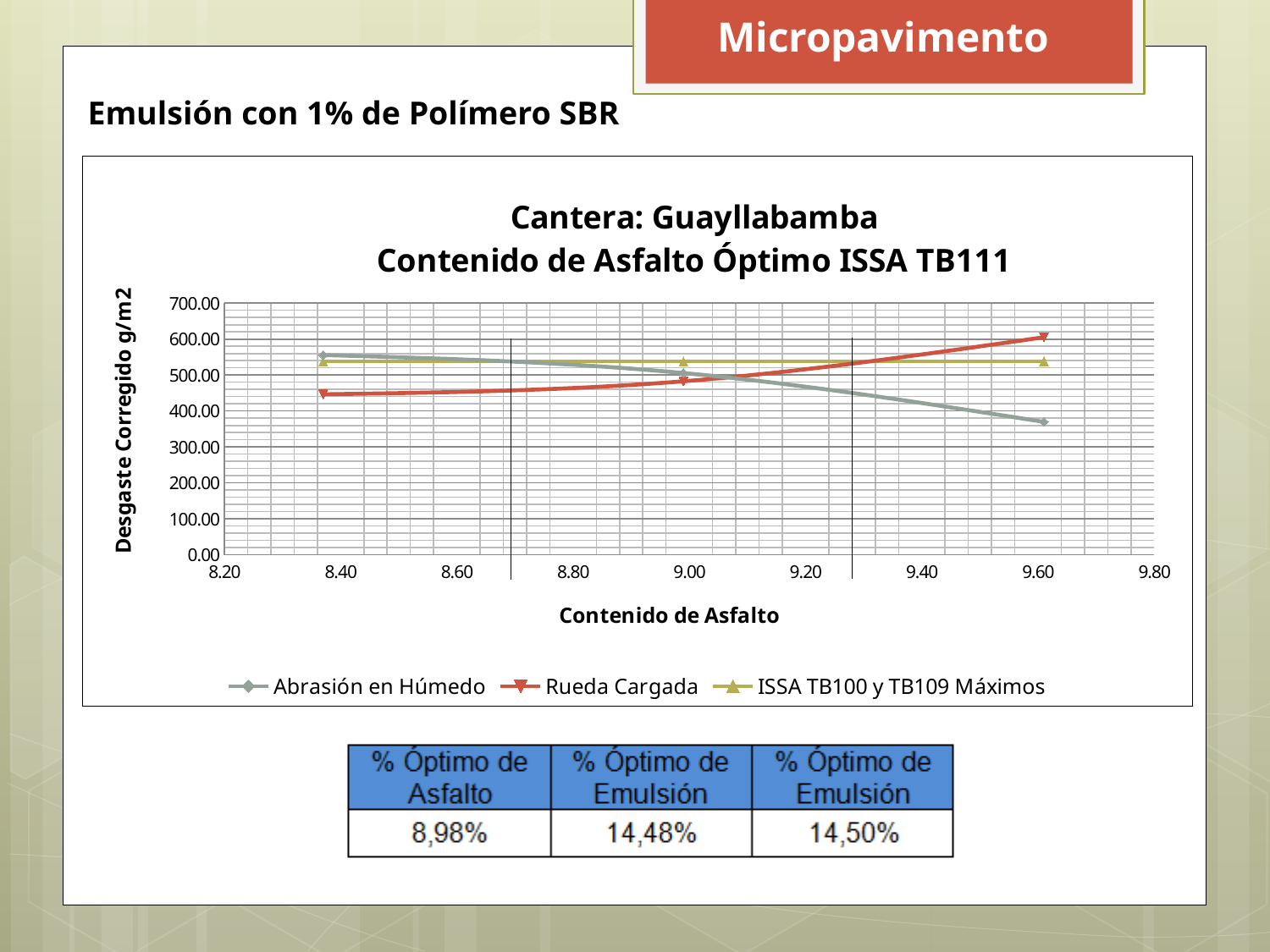
Is the value of Abrasión en Húmedo at its leftmost point greater or less than 500.00? greater At the leftmost data point, which series is higher: Abrasión en Húmedo or Rueda Cargada? Abrasión en Húmedo Does the Abrasión en Húmedo series rise or fall as Contenido de Asfalto increases? fall At the rightmost data point, which series has the highest value? Rueda Cargada What is the label of the vertical axis of the chart? Desgaste Corregido g/m2 What kind of chart is shown on the slide? line chart Is the value of Rueda Cargada at its leftmost point greater or less than 500.00? less Does the Rueda Cargada series rise or fall as Contenido de Asfalto increases? rise Is the ISSA TB100 y TB109 Máximos line greater or less than 500.00? greater What is the title of the chart? Cantera: Guayllabamba Contenido de Asfalto Óptimo ISSA TB111 How many series does the chart legend list? 3